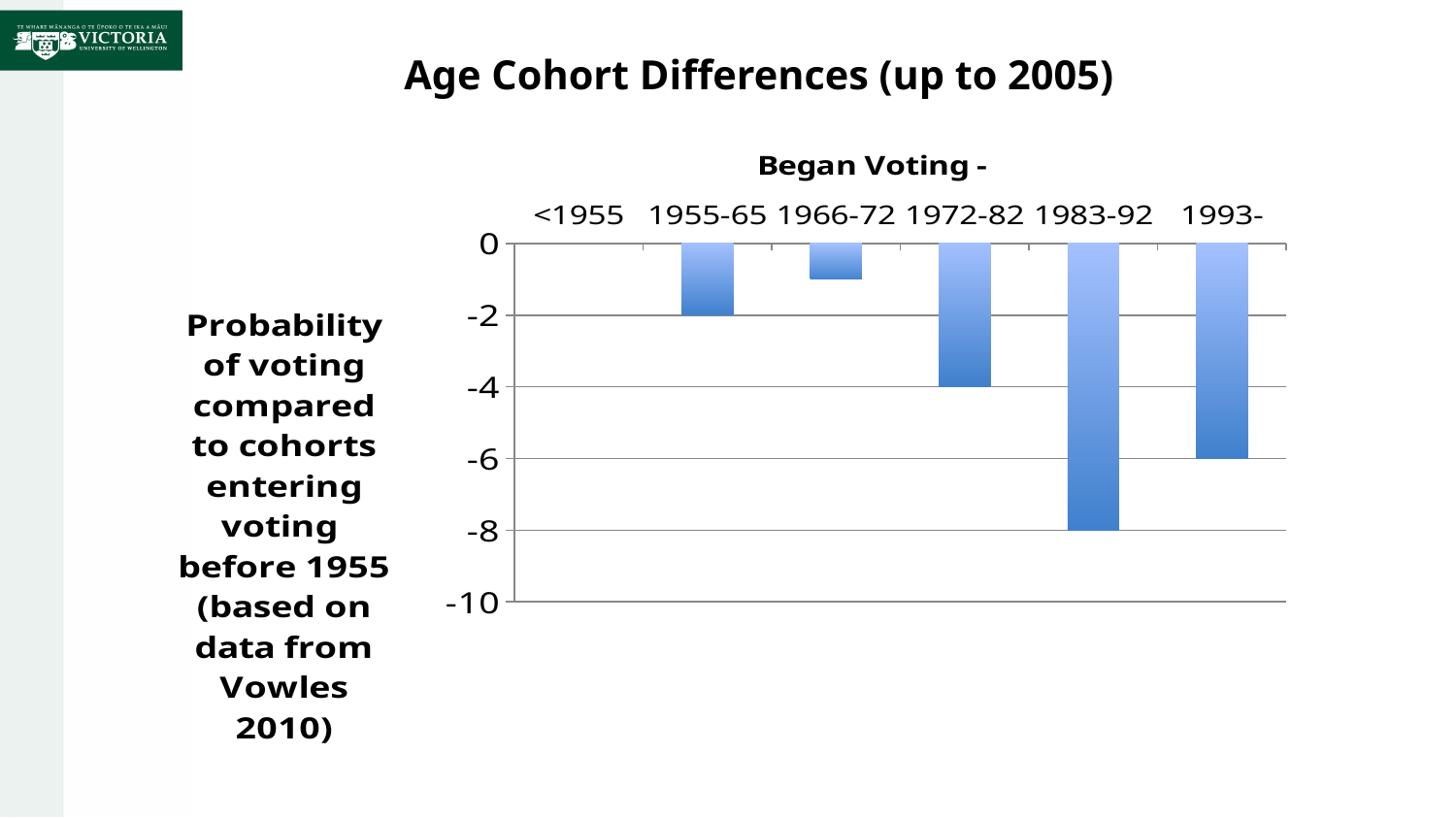
What is the difference between the values for the 1983-92 and 1993- cohorts? 2 Which cohort has the lowest (most negative) value? 1983-92 What is the difference between the values for the 1983-92 and 1955-65 cohorts? 6 What is the value for the 1955-65 cohort? -2 What is the title shown above the chart's x axis? Began Voting - How many cohort categories are shown on the x axis? 6 What is the value for the 1993- cohort? -6 What is the value for the 1972-82 cohort? -4 Which cohort has the lower value, 1972-82 or 1993-? 1993- What is the value for the 1983-92 cohort? -8 Is the value for the 1966-72 cohort greater or less than -2? greater What kind of chart is shown on the slide? bar chart